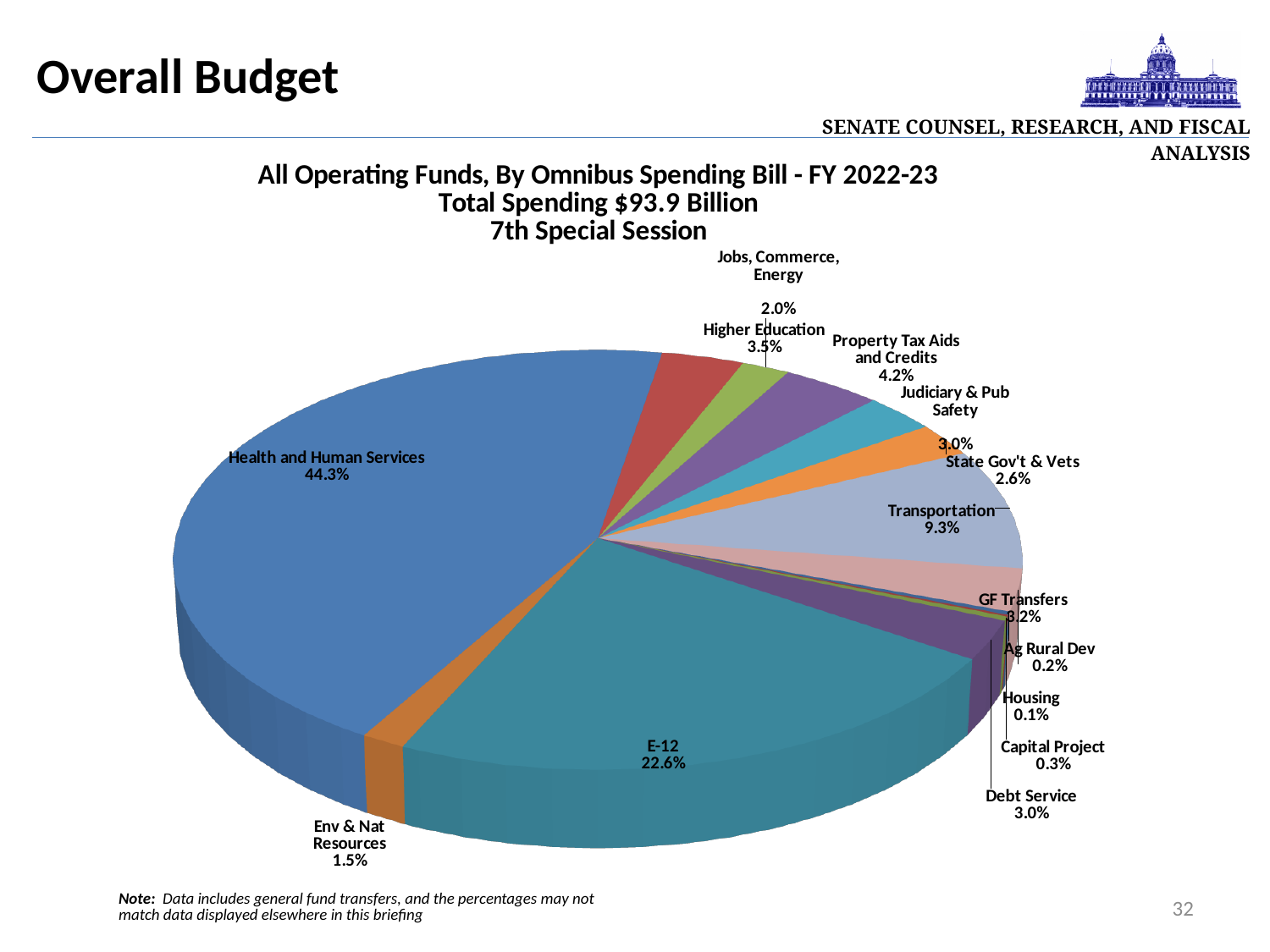
How many categories are shown in the pie chart? 14 What total spending amount is stated in the chart title? $93.9 Billion Which category has the largest slice of the pie? Health and Human Services Which category has the smallest slice of the pie? Housing Which is larger, Higher Education or Jobs, Commerce, Energy? Higher Education What percentage is shown for Property Tax Aids and Credits? 4.2% What kind of chart is shown on the slide? pie chart What is the value shown for Transportation? 9.3% What is the difference in percentage points between Health and Human Services and E-12? 21.7 What share of spending goes to Health and Human Services? 44.3% What percentage of the pie is E-12? 22.6% What is the value shown for Debt Service? 3.0%